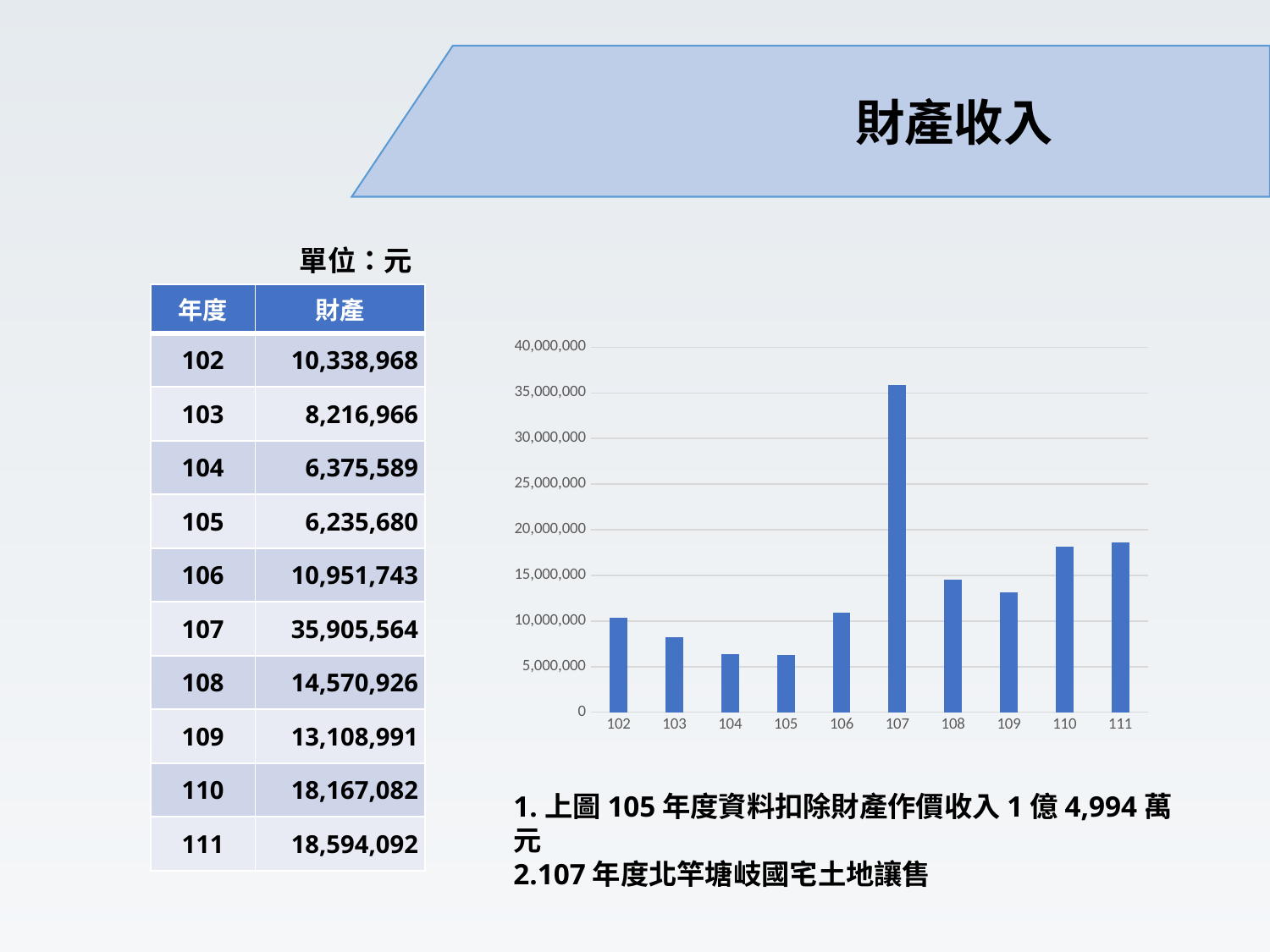
Is the value for year 107 in the chart greater or less than 35,000,000? greater Is the value for year 104 in the chart greater or less than 10,000,000? less Which year has the lowest bar in the chart? 105 How many years (categories) are plotted on the x axis of the chart? 10 Is the value for year 110 in the chart greater or less than 15,000,000? greater What unit is stated for the values on the slide? 元 What type of chart is shown on the slide? bar chart According to the table on the slide, what is the 財產 value for year 107? 35,905,564 According to the table on the slide, what is the 財產 value for year 111? 18,594,092 Which year has the highest bar in the chart? 107 Which is larger in the chart, the value for year 108 or the value for year 109? 108 Using the values in the table, what is the difference between the 財產 values for years 111 and 110? 427,010